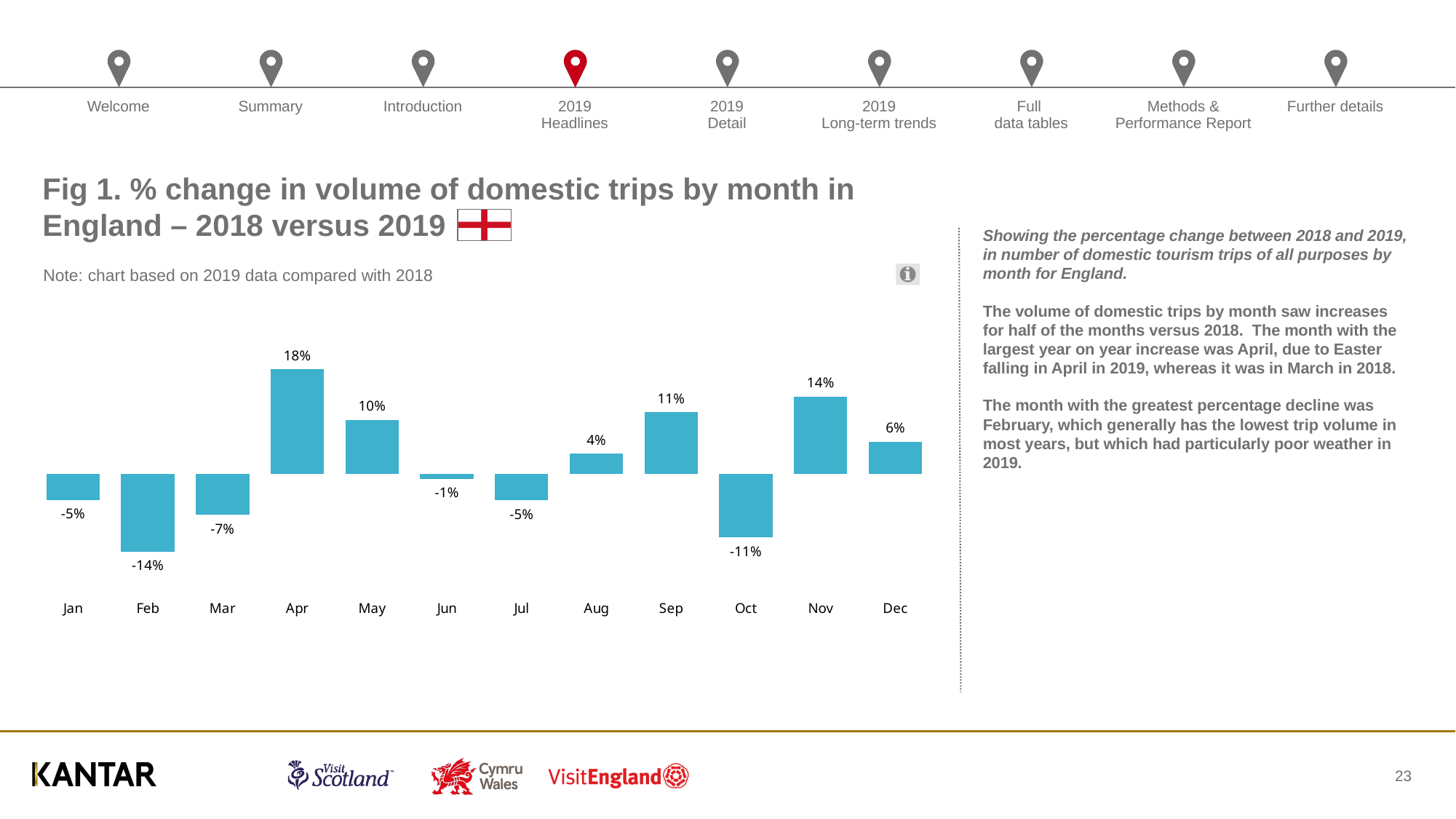
What kind of chart is shown on the slide? Bar chart Which month has the lowest % change in volume of domestic trips? Feb How many months show a negative % change in volume of domestic trips? 6 Which month has the highest % change in volume of domestic trips? Apr How many months are shown on the chart? 12 What is the title of the chart? Fig 1. % change in volume of domestic trips by month in England – 2018 versus 2019 What is the % change in volume of domestic trips for June? -1% What is the % change in volume of domestic trips for October? -11% What is the % change in volume of domestic trips for April? 18% What is the % change in volume of domestic trips for February? -14% What is the difference between the % change for November and the % change for December? 8 percentage points Which month has a larger % change in volume of domestic trips, May or September? Sep